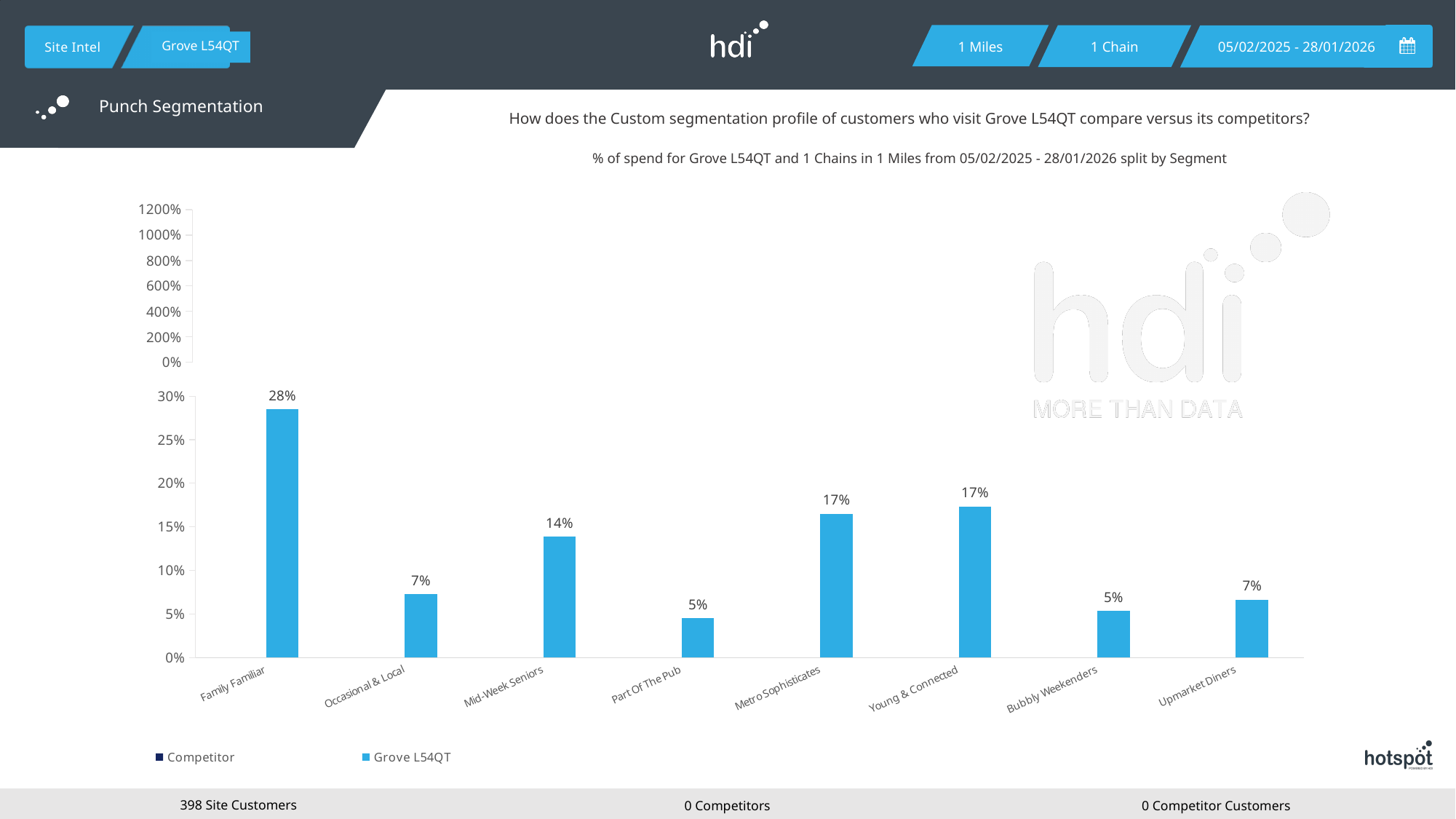
What is the Grove L54QT % of spend for Family Familiar? 28% How many segments are shown on the x axis of the chart? 8 What is the Grove L54QT % of spend for Mid-Week Seniors? 14% What is the difference between the Grove L54QT % of spend for Family Familiar and Metro Sophisticates? 11% How many series does the chart legend list? 2 What is the Grove L54QT % of spend for Part Of The Pub? 5% Which has a larger Grove L54QT % of spend, Young & Connected or Bubbly Weekenders? Young & Connected Which segment has the highest Grove L54QT % of spend? Family Familiar What is the Grove L54QT % of spend for Upmarket Diners? 7% Is the Grove L54QT % of spend for Metro Sophisticates greater or less than 15%? greater What is the difference between the Grove L54QT % of spend for Mid-Week Seniors and Occasional & Local? 7% What type of chart is used to show the % of spend by segment? Bar chart